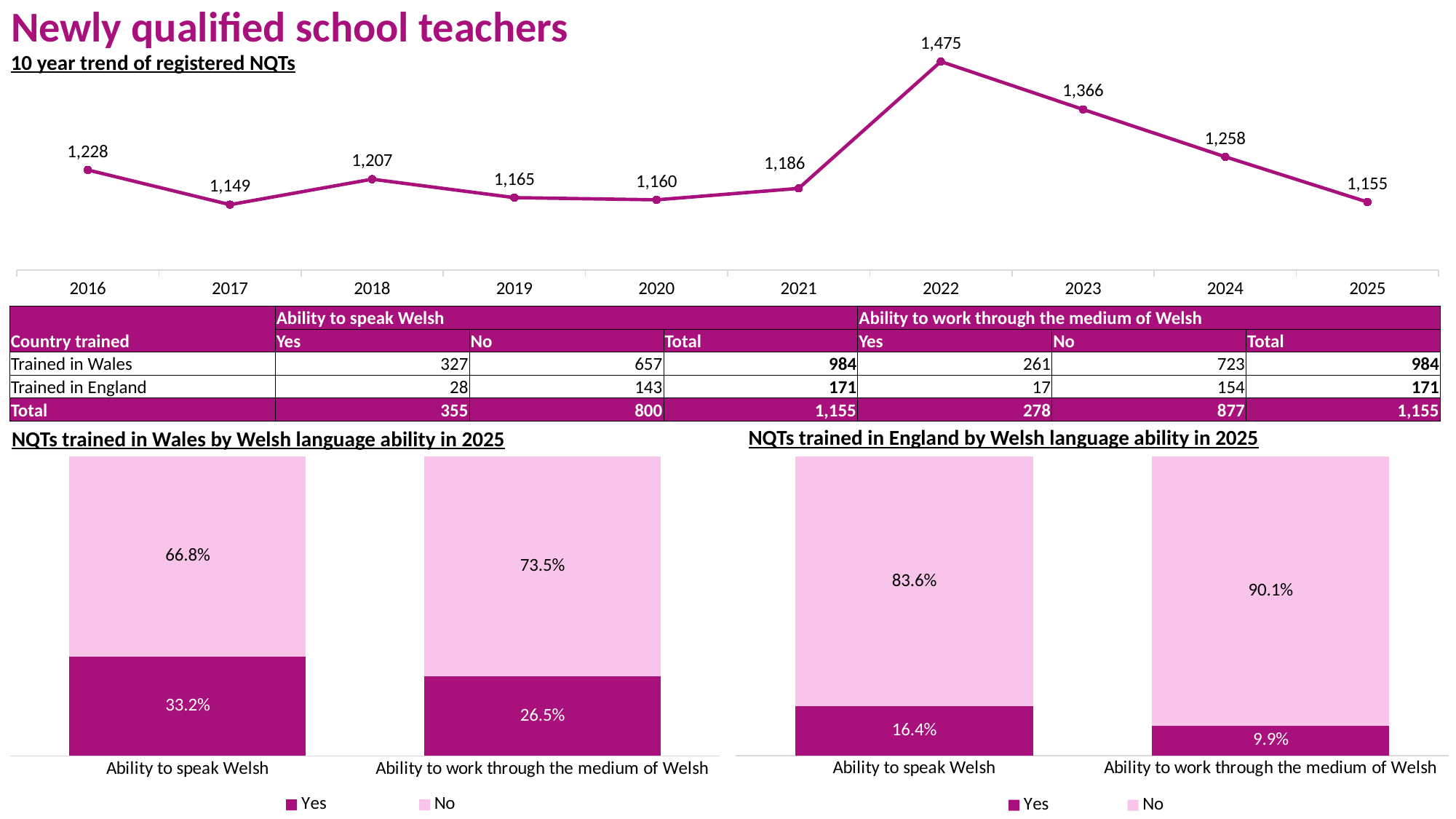
In the 'NQTs trained in England by Welsh language ability in 2025' chart, which is larger: the 'Yes' share for 'Ability to speak Welsh' or the 'Yes' share for 'Ability to work through the medium of Welsh'? Ability to speak Welsh In the '10 year trend of registered NQTs' chart, do the values rise or fall from 2022 to 2025? Fall In the '10 year trend of registered NQTs' chart, what is the value for 2022? 1,475 In the 'NQTs trained in England by Welsh language ability in 2025' chart, what is the 'No' share for 'Ability to work through the medium of Welsh'? 90.1% In the '10 year trend of registered NQTs' chart, which year has the lowest value? 2017 What kind of chart is the 'NQTs trained in England by Welsh language ability in 2025' chart? Stacked bar chart How many series does the legend of the 'NQTs trained in Wales by Welsh language ability in 2025' chart list? 2 In the '10 year trend of registered NQTs' chart, how many years are plotted? 10 In the 'NQTs trained in Wales by Welsh language ability in 2025' chart, what is the 'Yes' share for 'Ability to speak Welsh'? 33.2% What kind of chart is the '10 year trend of registered NQTs' chart? Line chart In the '10 year trend of registered NQTs' chart, what is the difference between the 2022 and 2023 values? 109 In the '10 year trend of registered NQTs' chart, which year has the highest value? 2022